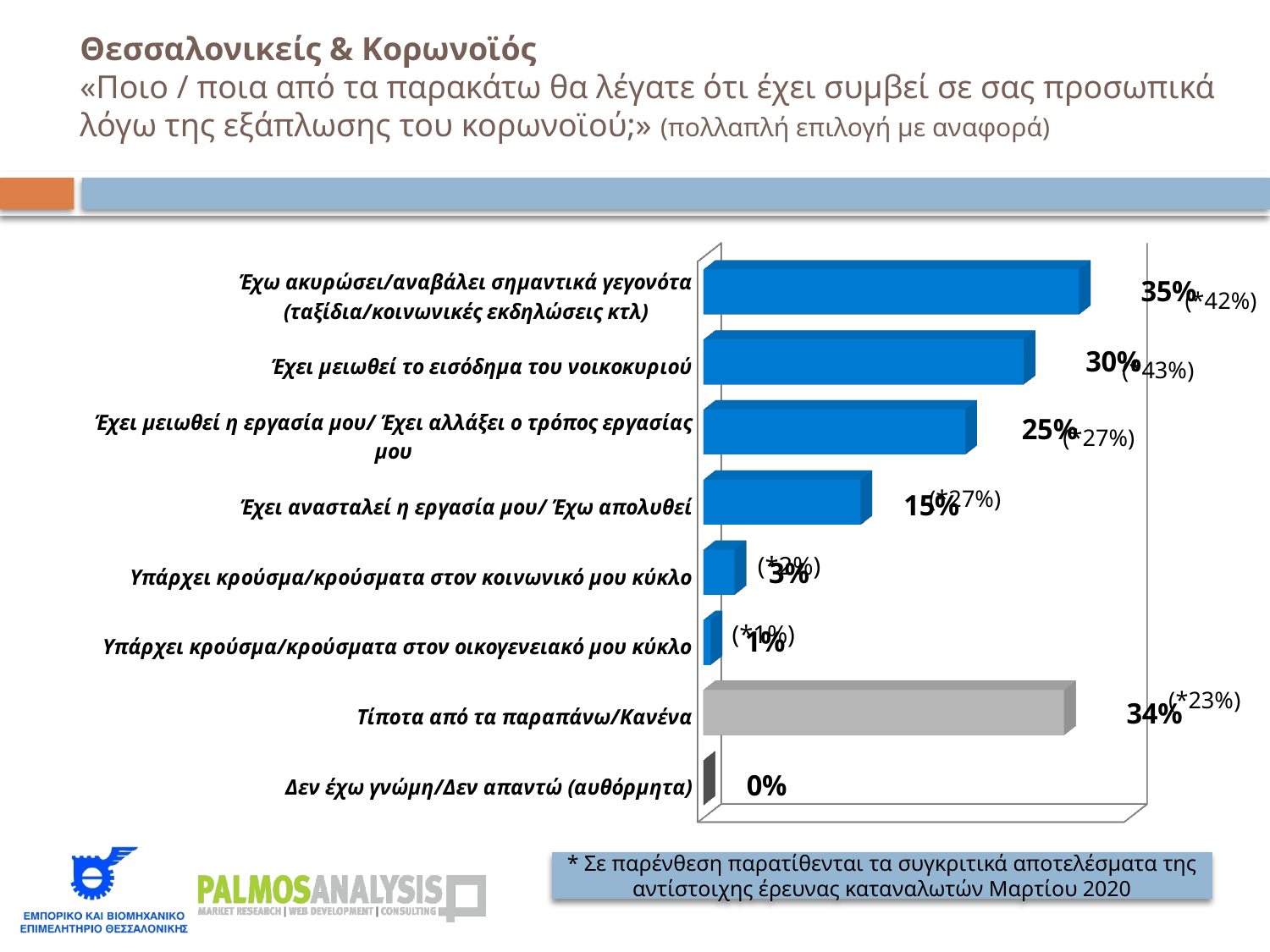
What is the difference between «Έχει μειωθεί το εισόδημα του νοικοκυριού» and «Έχει ανασταλεί η εργασία μου/ Έχω απολυθεί»? 15% What is the value for «Έχει μειωθεί το εισόδημα του νοικοκυριού»? 30% What is the value for «Δεν έχω γνώμη/Δεν απαντώ (αυθόρμητα)»? 0% What is the value for «Έχω ακυρώσει/αναβάλει σημαντικά γεγονότα (ταξίδια/κοινωνικές εκδηλώσεις κτλ)»? 35% Which category has the highest value? Έχω ακυρώσει/αναβάλει σημαντικά γεγονότα (ταξίδια/κοινωνικές εκδηλώσεις κτλ) Which category has the lowest value? Δεν έχω γνώμη/Δεν απαντώ (αυθόρμητα) What is the value for «Τίποτα από τα παραπάνω/Κανένα»? 34% How many categories are shown in the chart? 8 What kind of chart is shown on the slide? bar chart What is the value for «Έχει ανασταλεί η εργασία μου/ Έχω απολυθεί»? 15% What is the value for «Έχει μειωθεί η εργασία μου/ Έχει αλλάξει ο τρόπος εργασίας μου»? 25% Which is larger: «Έχει μειωθεί η εργασία μου/ Έχει αλλάξει ο τρόπος εργασίας μου» or «Τίποτα από τα παραπάνω/Κανένα»? Τίποτα από τα παραπάνω/Κανένα